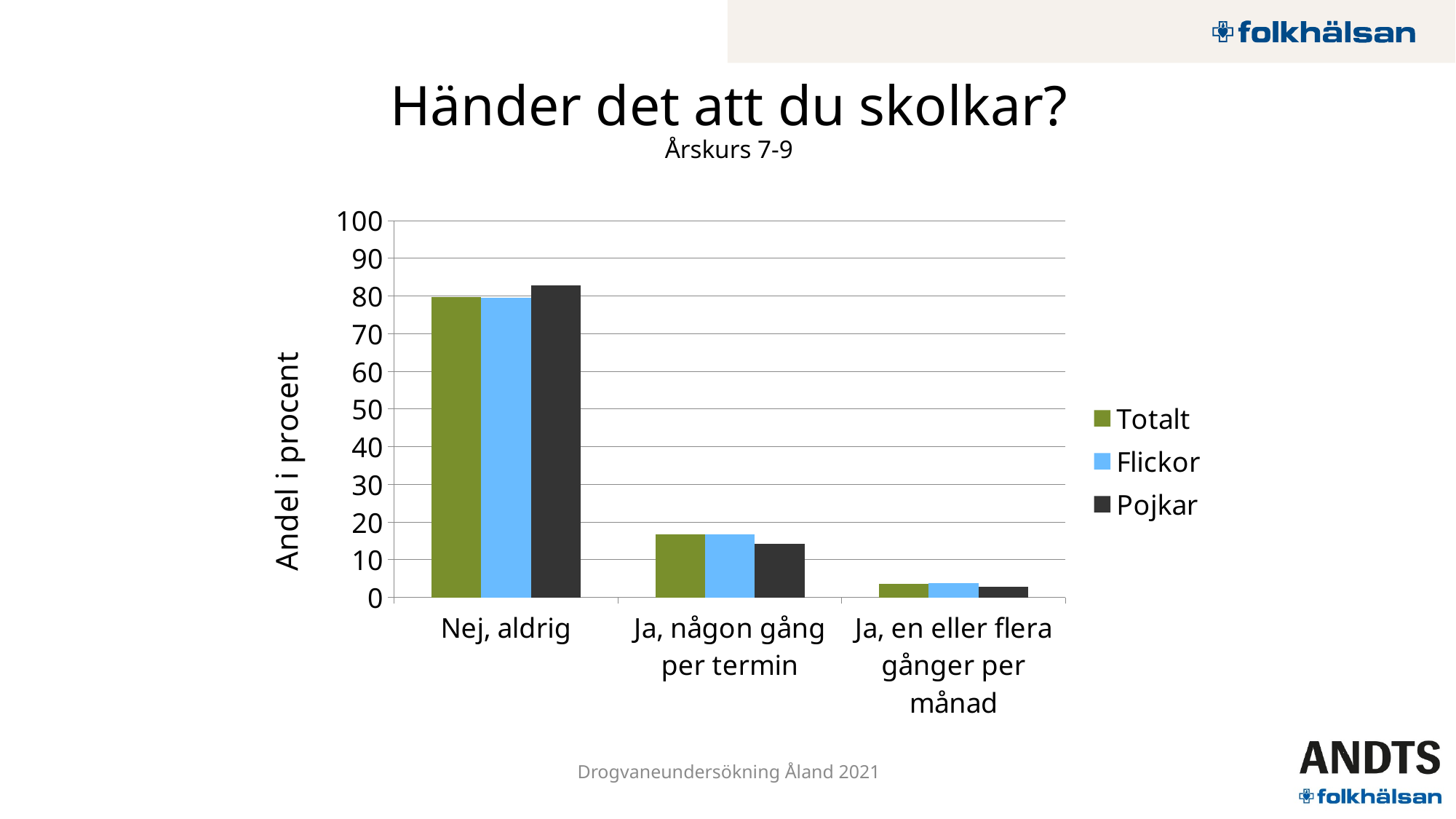
How many categories are shown on the x axis? 3 What kind of chart is shown on the slide? bar chart How many series does the legend list? 3 Is the Totalt value for "Ja, någon gång per termin" greater or less than 20? less Which category has the lowest value for the Pojkar series? Ja, en eller flera gånger per månad For "Ja, någon gång per termin", which series has the larger value, Totalt or Pojkar? Totalt What is the title of the vertical axis? Andel i procent For "Nej, aldrig", which series has the larger value, Flickor or Pojkar? Pojkar Do the Totalt values rise or fall from left to right along the x axis? fall Is the Flickor value for "Ja, en eller flera gånger per månad" greater or less than 10? less Is the Pojkar value for "Nej, aldrig" greater or less than 70? greater Which category has the highest value for the Totalt series? Nej, aldrig